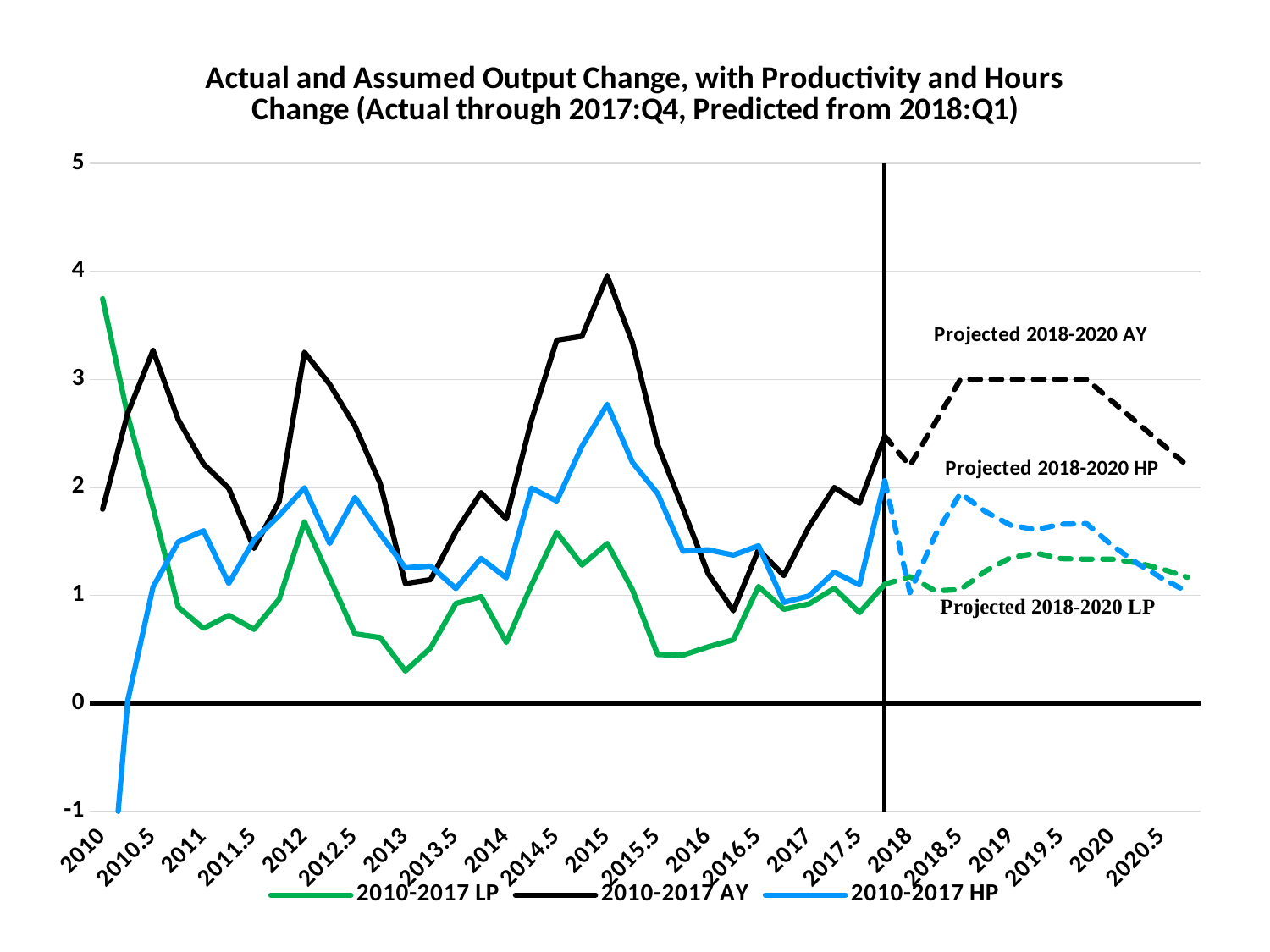
What kind of chart is shown on the slide? line chart Is the value for 2010-2017 HP at 2010 greater or less than 0? less Is the value for Projected 2018-2020 AY at 2019 greater or less than 2? greater Which series reaches the highest value on the chart? 2010-2017 AY Is the value for 2010-2017 LP at 2013 greater or less than 1? less At 2015, which is larger: 2010-2017 AY or 2010-2017 LP? 2010-2017 AY What colour is the 2010-2017 HP line? blue What is the title of the chart? Actual and Assumed Output Change, with Productivity and Hours Change (Actual through 2017:Q4, Predicted from 2018:Q1) At 2010, which is larger: 2010-2017 LP or 2010-2017 AY? 2010-2017 LP How many series does the legend list? 3